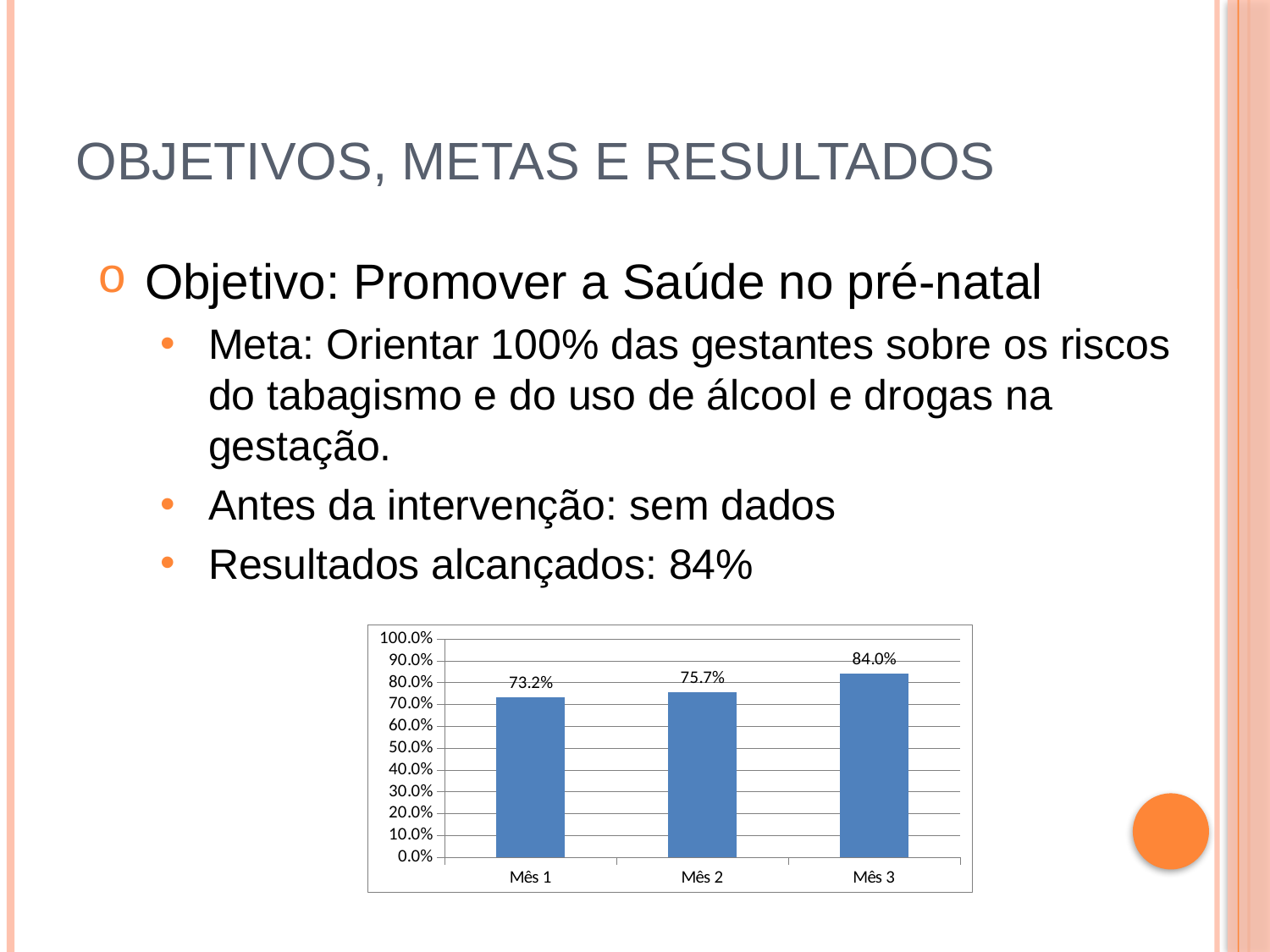
How many categories are shown on the x axis? 3 What kind of chart is shown on the slide? bar chart What is the difference between the values for Mês 2 and Mês 1? 2.5% What is the difference between the values for Mês 3 and Mês 1? 10.8% Which month has the highest value? Mês 3 Is the value for Mês 3 greater or less than 80.0%? greater What is the value for Mês 3? 84.0% Do the values rise or fall from Mês 1 to Mês 3? rise Which is larger, the value for Mês 2 or the value for Mês 3? Mês 3 What is the value for Mês 2? 75.7% What is the value for Mês 1? 73.2% Which month has the lowest value? Mês 1